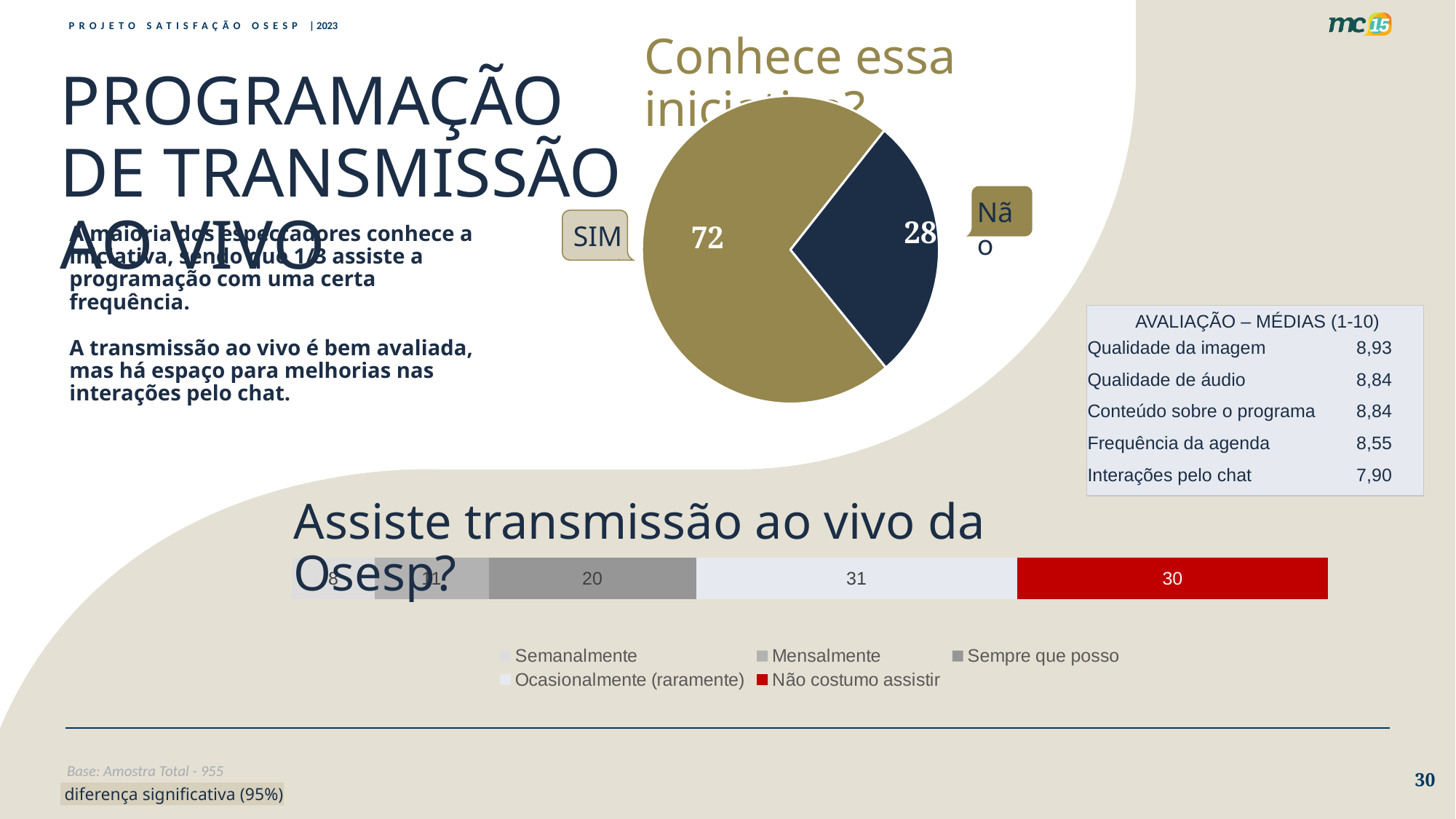
How many series does the legend of the chart 'Assiste transmissão ao vivo da Osesp?' list? 5 In the pie chart 'Conhece essa iniciativa?', what is the difference between the SIM and Não values? 44 In the chart 'Assiste transmissão ao vivo da Osesp?', what colour is the 'Não costumo assistir' segment? Red What kind of chart is 'Conhece essa iniciativa?'? Pie chart In the chart 'Assiste transmissão ao vivo da Osesp?', what is the value for 'Não costumo assistir'? 30 In the pie chart 'Conhece essa iniciativa?', what is the value for SIM? 72 In the chart 'Assiste transmissão ao vivo da Osesp?', what is the value for 'Sempre que posso'? 20 What kind of chart is 'Assiste transmissão ao vivo da Osesp?'? Bar chart In the chart 'Assiste transmissão ao vivo da Osesp?', what is the value for 'Ocasionalmente (raramente)'? 31 In the pie chart 'Conhece essa iniciativa?', which slice is larger, SIM or Não? SIM How many slices does the pie chart 'Conhece essa iniciativa?' have? 2 In the pie chart 'Conhece essa iniciativa?', what is the value for Não? 28